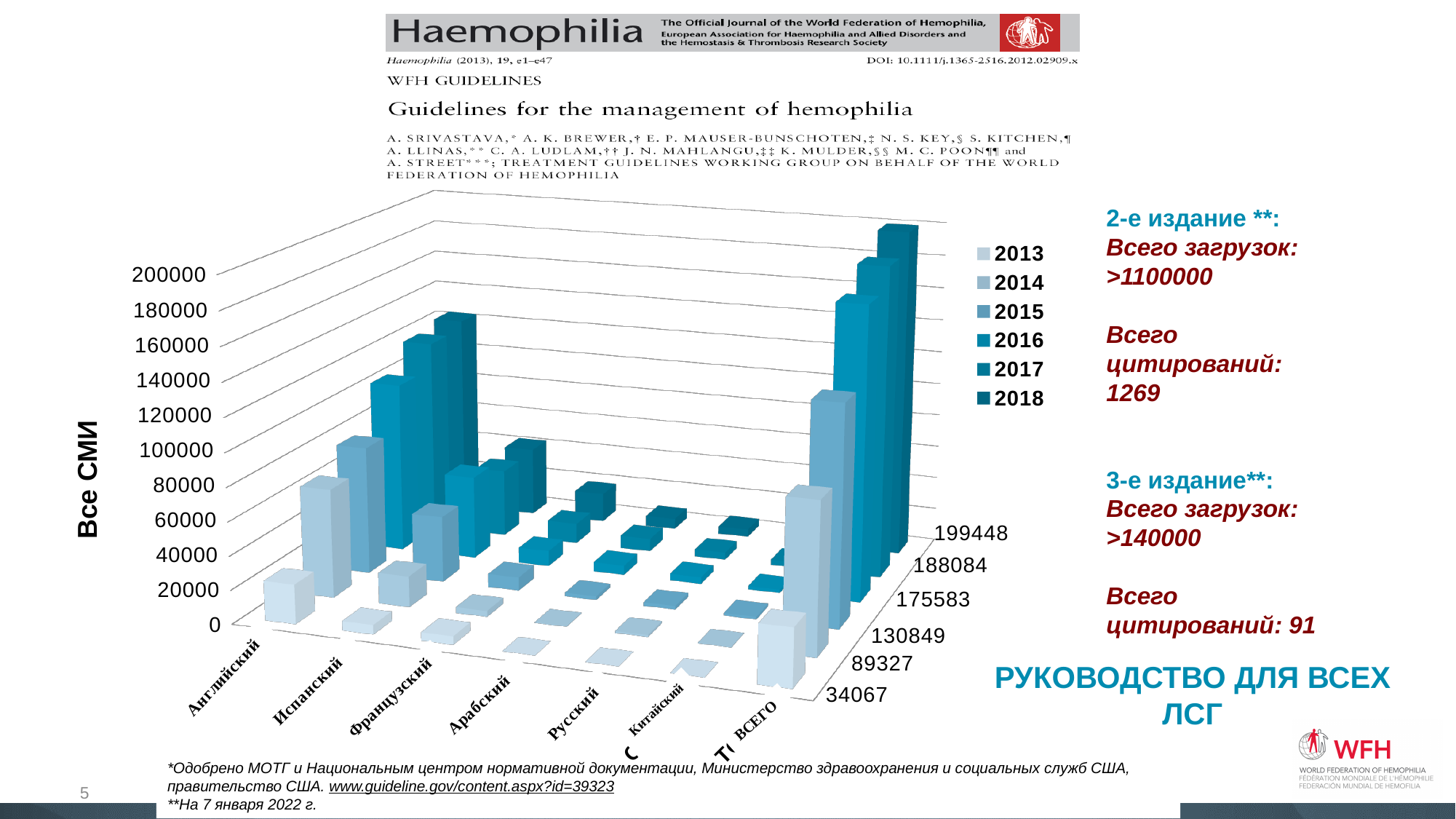
What kind of chart is shown on the slide? bar chart What is the value for ВСЕГО in 2013? 34067 Do the ВСЕГО values rise or fall from 2013 to 2018? rise Which year has the highest ВСЕГО value? 2018 What is the value for ВСЕГО in 2015? 130849 What is the difference between the ВСЕГО values for 2014 and 2013? 55260 What is the value for ВСЕГО in 2018? 199448 Which year has the lowest ВСЕГО value? 2013 What is the difference between the ВСЕГО values for 2018 and 2017? 11364 What is the label on the vertical axis of the chart? Все СМИ What is the value for ВСЕГО in 2017? 188084 How many series does the chart legend list? 6